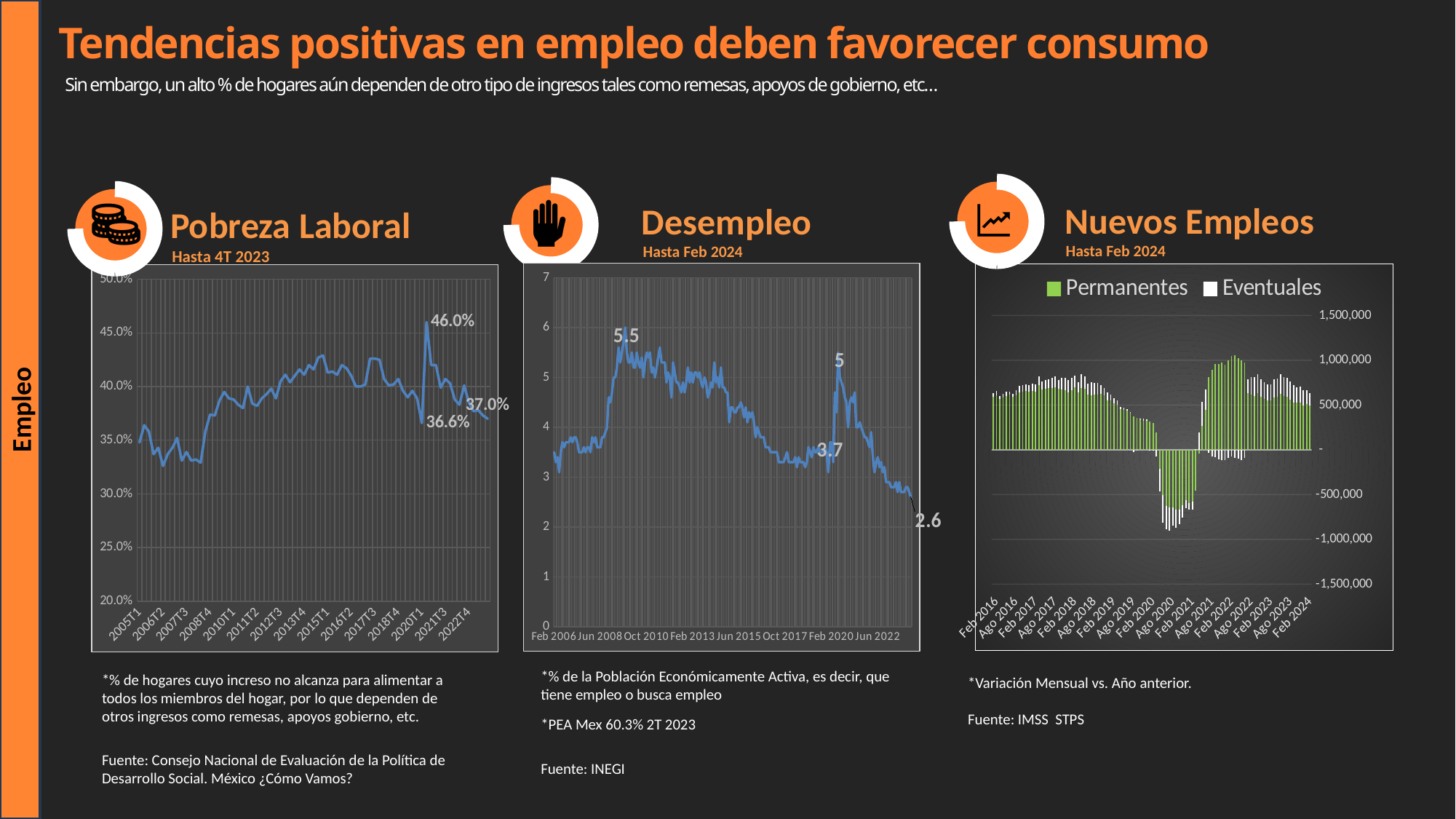
What type of chart is the Pobreza Laboral chart? Line chart In the Desempleo chart, what is the difference between the 5.5 peak and the final value of 2.6? 2.9 In the Nuevos Empleos chart, are the values around Ago 2020 greater or less than 0? less In the Desempleo chart, what is the highest labelled value? 5.5 In the Pobreza Laboral chart, what is the highest labelled value? 46.0% How many series does the legend of the Nuevos Empleos chart list? 2 In the Nuevos Empleos chart, which colour represents Permanentes? Green In the Desempleo chart, what is the lowest labelled value? 2.6 In the Desempleo chart, which labelled value is larger: the 5 spike around 2020 or the 3.7 label before it? 5 In the Desempleo chart, is the value at the end of the series (Feb 2024) greater or less than 3? less In the Pobreza Laboral chart, what is the difference between the 46.0% peak and the 36.6% label that follows it? 9.4 percentage points In the Pobreza Laboral chart, what is the last labelled value at the end of the series? 37.0%